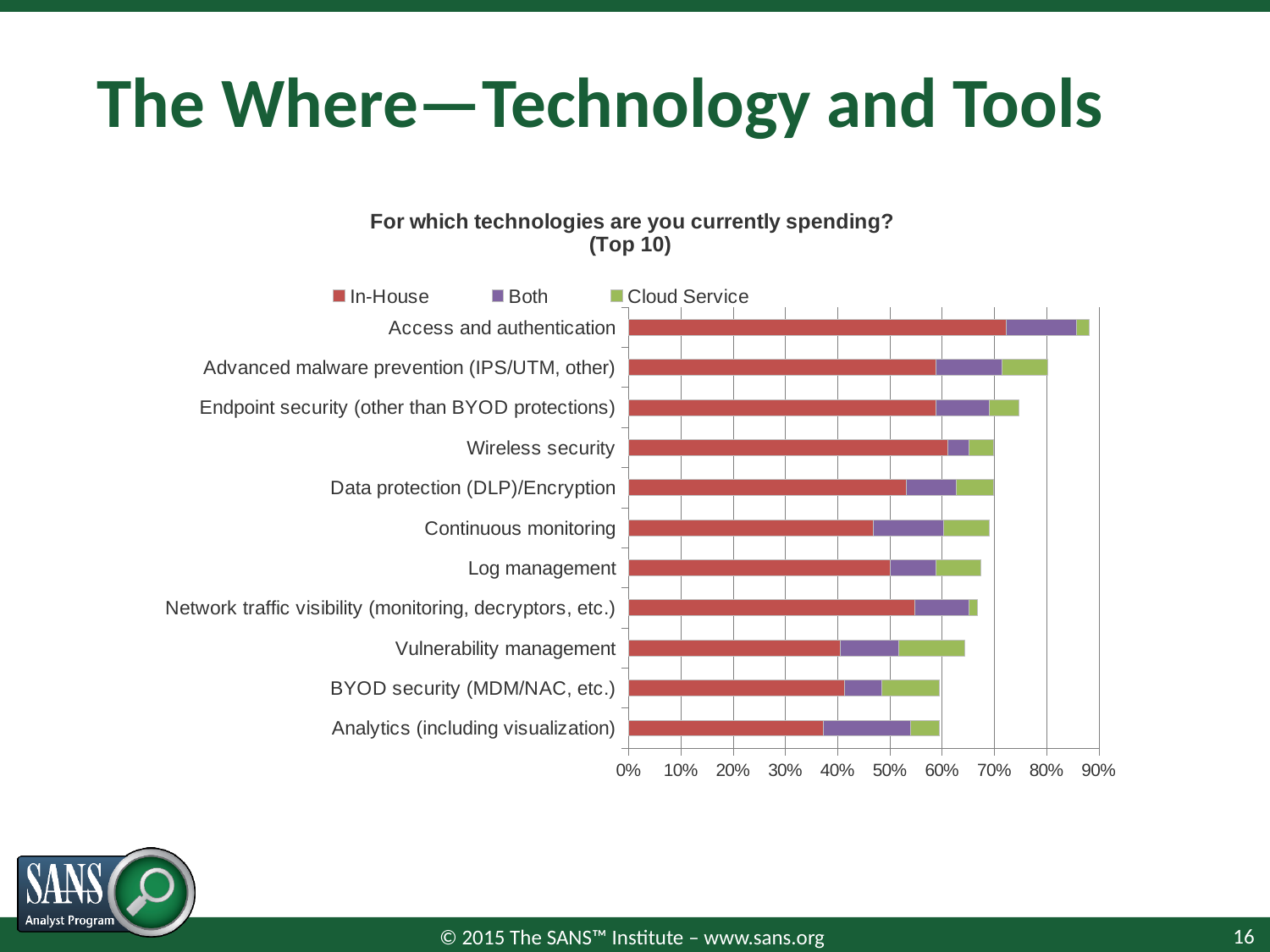
What kind of chart is shown on the slide? Stacked bar chart How many technology categories are plotted in the chart? 11 How many series does the legend list? 3 Is the total bar for Access and authentication greater or less than 80%? greater Is the In-House value for Analytics (including visualization) greater or less than 40%? less Is the In-House value for Continuous monitoring greater or less than 50%? less Which technology has the longest total bar? Access and authentication Which has the longer total bar, Access and authentication or Analytics (including visualization)? Access and authentication What is the title of the chart? For which technologies are you currently spending? (Top 10) Which has the larger In-House segment, Wireless security or Vulnerability management? Wireless security Which technology has the largest In-House segment? Access and authentication